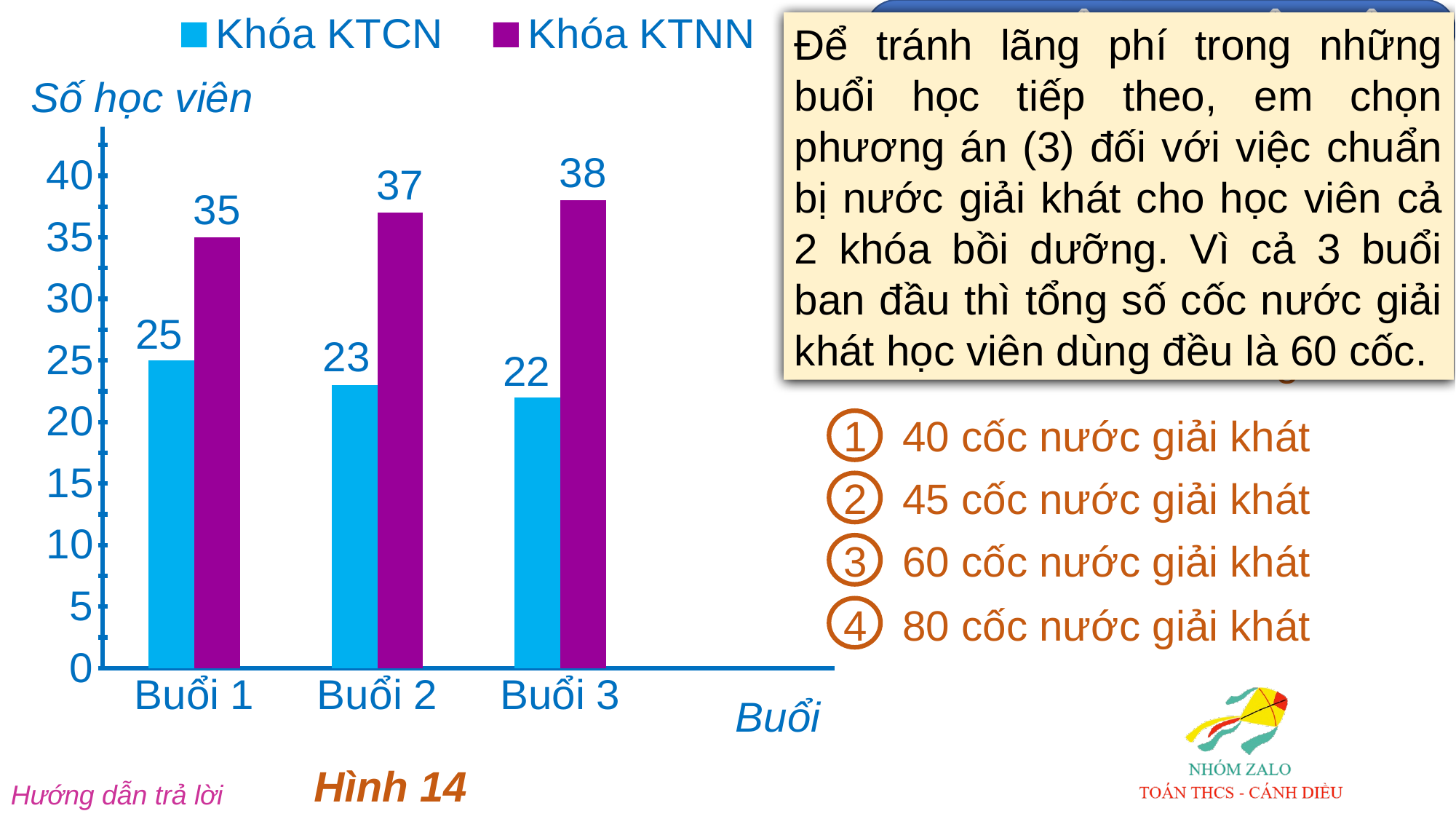
What is the label of the vertical axis? Số học viên What is the value for Khóa KTCN in Buổi 1? 25 Do the values for Khóa KTCN rise or fall from Buổi 1 to Buổi 3? Fall How many series does the legend list? 2 What is the difference between Khóa KTNN and Khóa KTCN in Buổi 1? 10 What kind of chart is shown? Bar chart What is the value for Khóa KTCN in Buổi 3? 22 Which session (Buổi) has the highest value for Khóa KTNN? Buổi 3 How many sessions (Buổi) are shown on the x axis? 3 What is the value for Khóa KTNN in Buổi 2? 37 Which is larger in Buổi 2: Khóa KTCN or Khóa KTNN? Khóa KTNN Which session (Buổi) has the lowest value for Khóa KTCN? Buổi 3